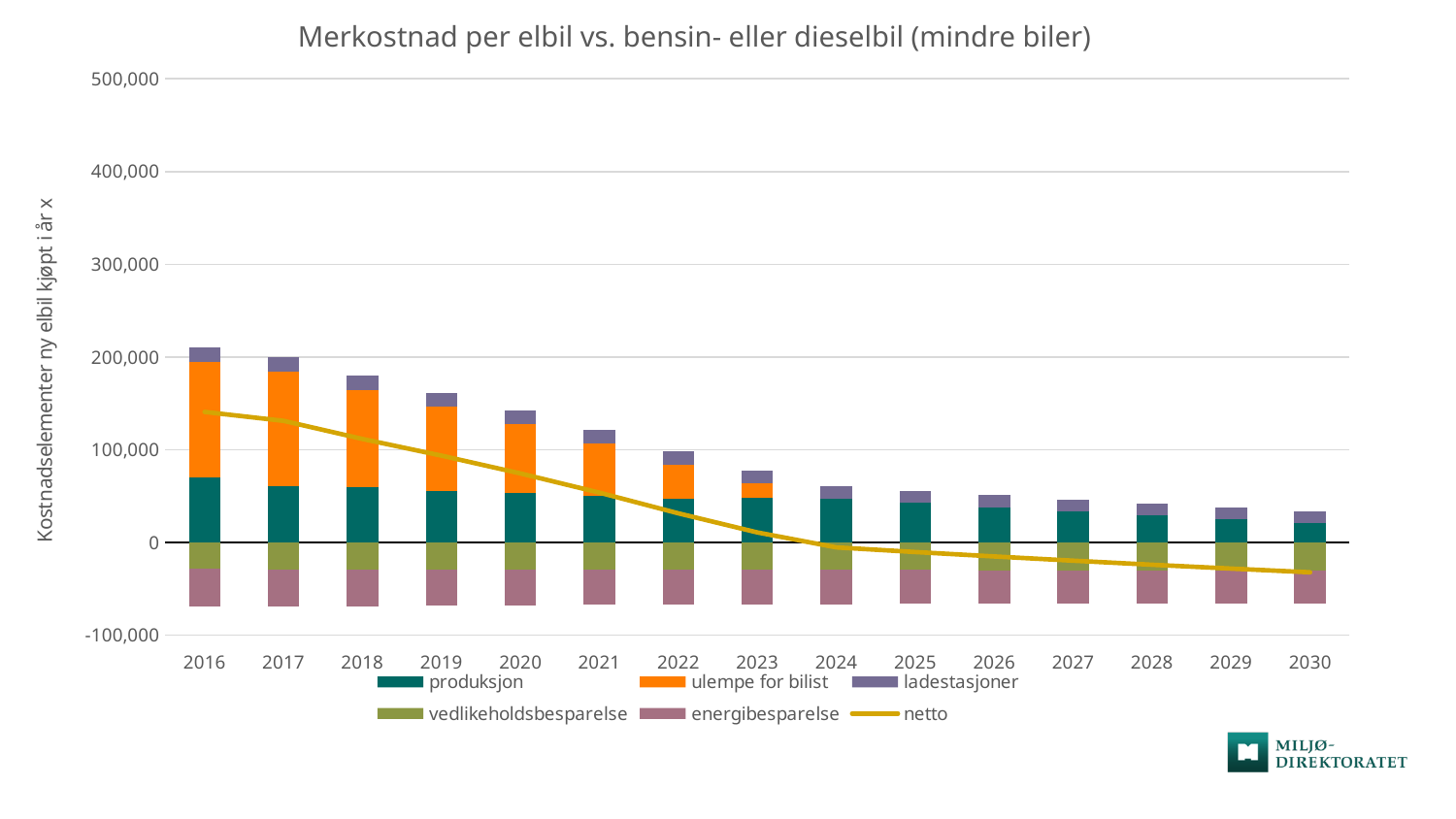
What is the title of the chart? Merkostnad per elbil vs. bensin- eller dieselbil (mindre biler) Is the produksjon value for 2016 greater or less than 50,000? greater Which is larger, the netto value for 2016 or for 2030? 2016 Which year has the shortest positive stacked bar? 2030 Is the top of the positive stacked bar for 2016 greater or less than 150,000? greater Is the netto value for 2030 greater or less than 0? less How many series does the legend list? 6 How many years are shown along the x axis? 15 Which year has the tallest positive stacked bar? 2016 Does the netto line rise or fall from 2016 to 2030? Fall What kind of chart is shown on the slide? Stacked bar chart with a line